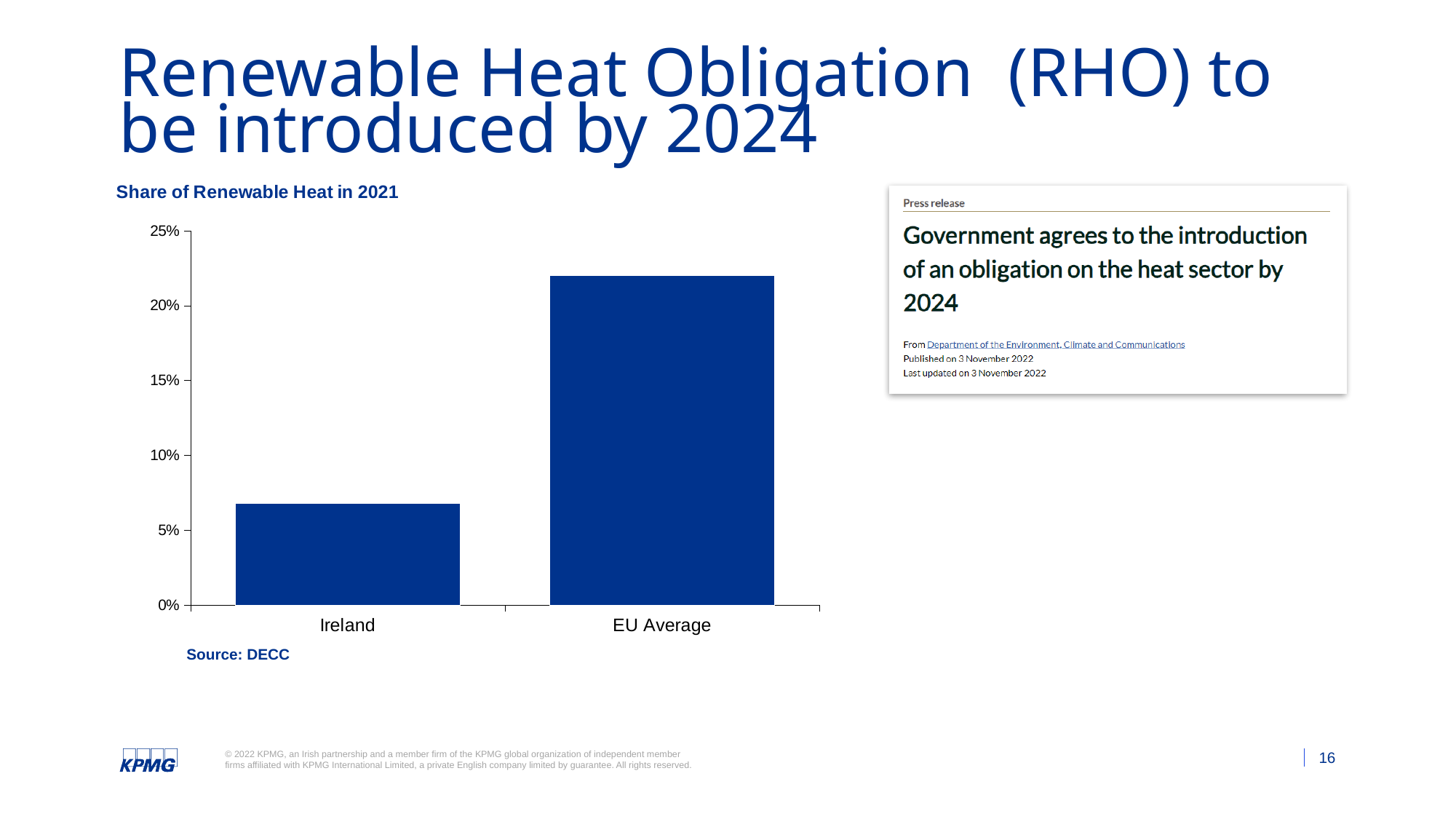
Is the value for Ireland greater or less than 5%? greater What is the title of the chart? Share of Renewable Heat in 2021 What source is cited below the chart? DECC Is the value for Ireland greater or less than 10%? less Which category has the highest share of renewable heat in 2021? EU Average What type of chart is shown on the slide? bar chart Is the value for EU Average greater or less than 25%? less Which is larger, the value for Ireland or the value for EU Average? EU Average How many categories are plotted in the chart? 2 Which category has the lowest share of renewable heat in 2021? Ireland